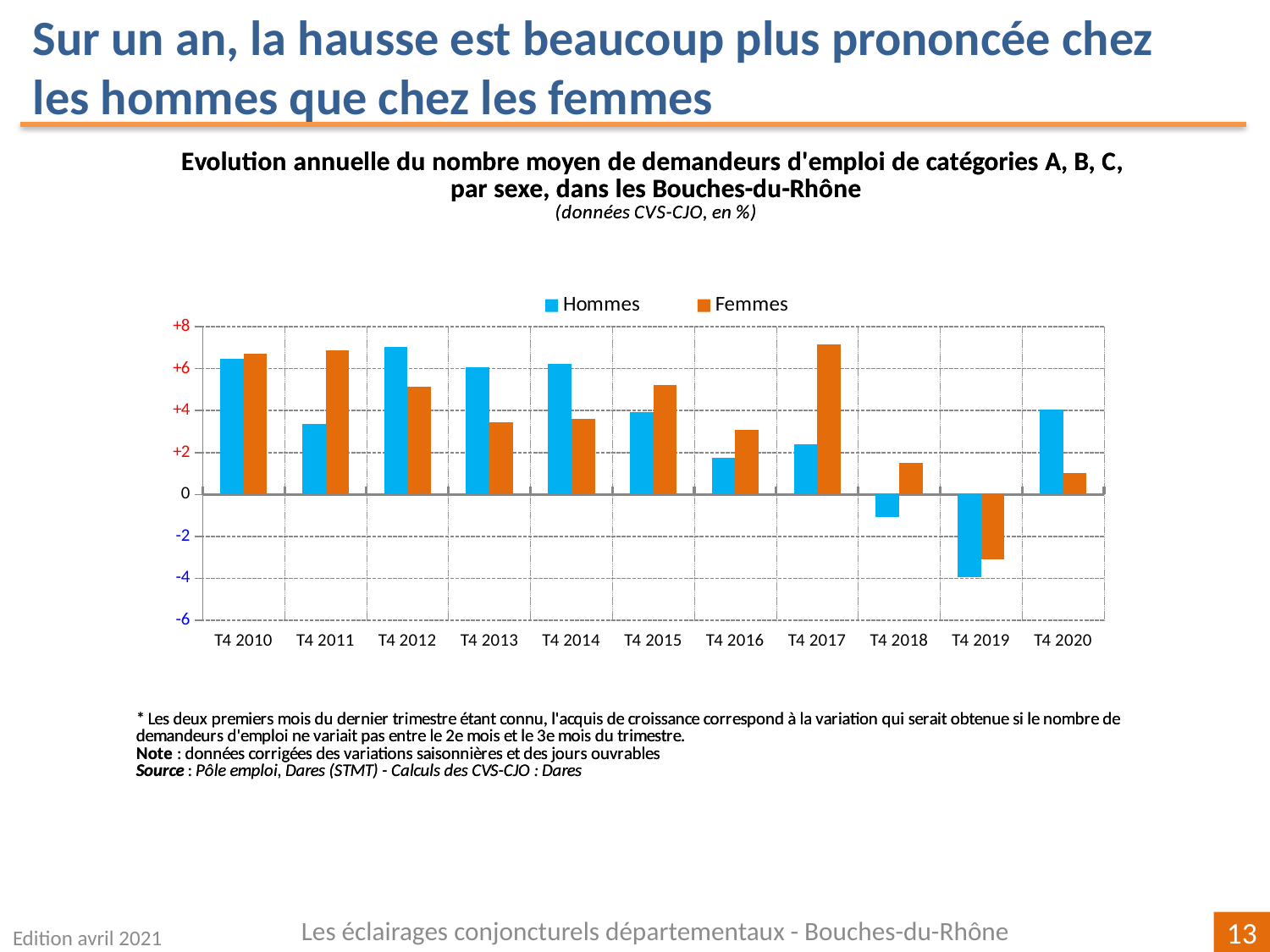
In T4 2017, which is larger, the value for Hommes or for Femmes? Femmes Which series is shown in orange? Femmes What kind of chart is shown on the slide? bar chart In which quarter is the value for Hommes the highest? T4 2012 How many quarters (categories) are shown on the x axis? 11 Is the value for Hommes in T4 2018 greater or less than 0? less Is the value for Hommes in T4 2019 greater or less than -2? less Is the value for Hommes in T4 2012 greater or less than +6? greater How many series does the legend list? 2 In which quarter is the value for Hommes the lowest? T4 2019 In T4 2020, which is larger, the value for Hommes or for Femmes? Hommes